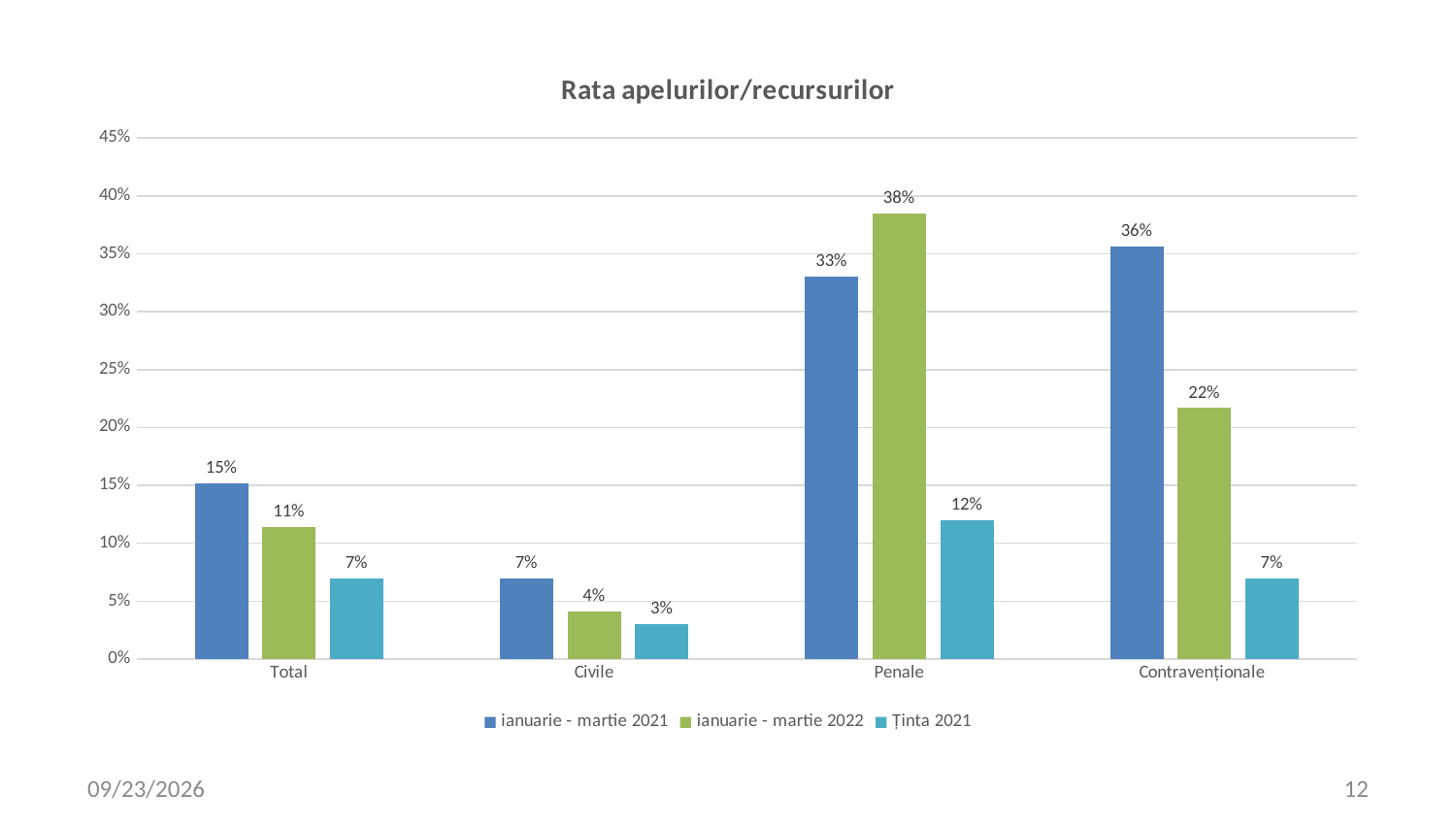
Which category has the lowest value in the Ținta 2021 series? Civile Which category has the highest value in the ianuarie - martie 2021 series? Contravenționale What is the difference between the ianuarie - martie 2021 and ianuarie - martie 2022 values for Contravenționale? 14% What is the title of the chart? Rata apelurilor/recursurilor What kind of chart is shown on the slide? Bar chart How many categories are shown on the x axis? 4 How many series does the legend list? 3 What is the Ținta 2021 value for Civile? 3% What is the value for Contravenționale in the ianuarie - martie 2021 series? 36% What is the value for Penale in the ianuarie - martie 2022 series? 38% What is the value for Total in the ianuarie - martie 2022 series? 11% For Penale, which is larger: the ianuarie - martie 2021 value or the ianuarie - martie 2022 value? ianuarie - martie 2022